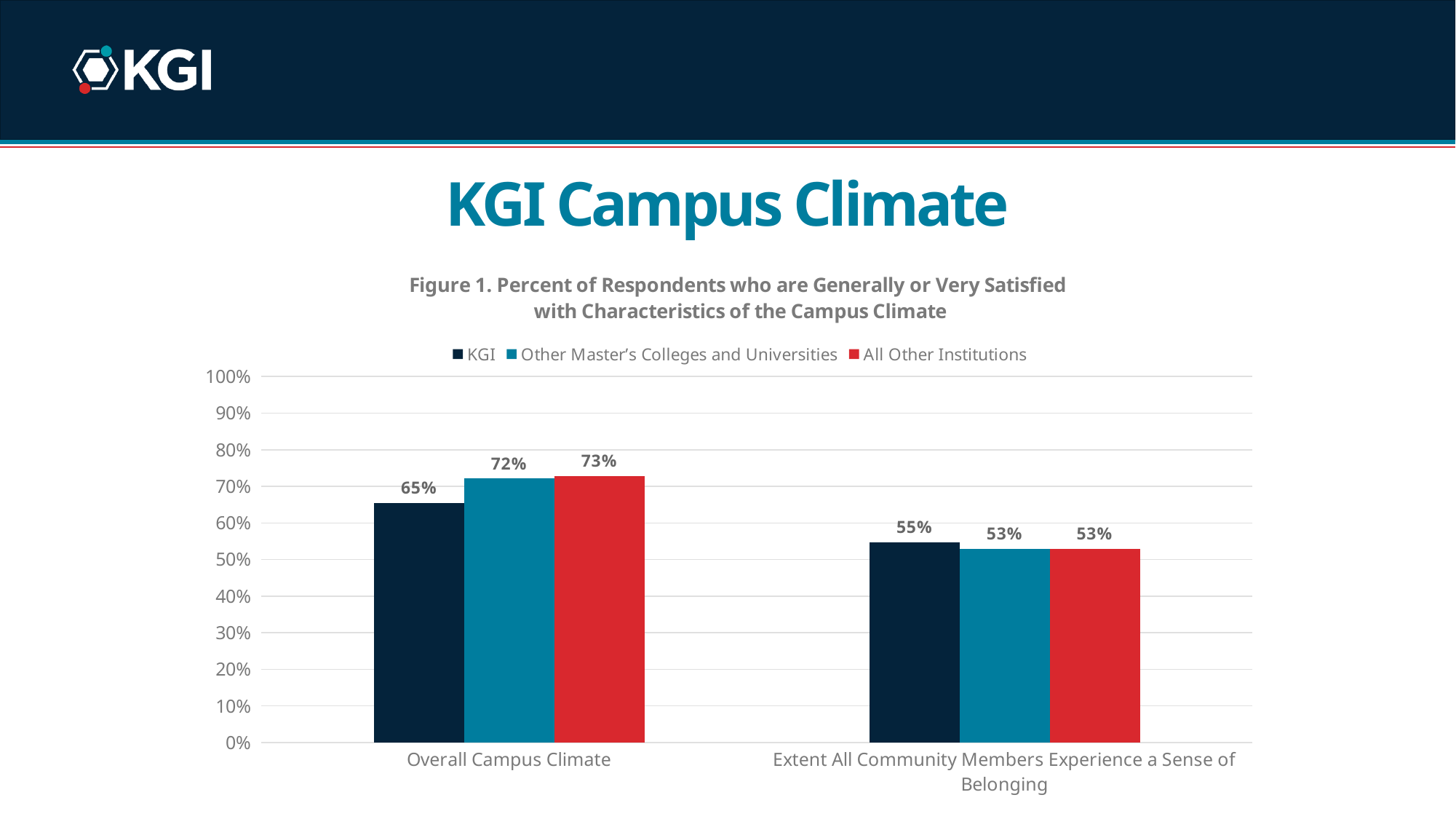
Which series has the highest value for Extent All Community Members Experience a Sense of Belonging? KGI What is the KGI value for Overall Campus Climate? 65% What is the value for All Other Institutions for Extent All Community Members Experience a Sense of Belonging? 53% How many categories are shown on the x axis? 2 What kind of chart is shown on the slide? bar chart What colour represents the All Other Institutions series? red How many series does the legend list? 3 What is the difference between the KGI values for Overall Campus Climate and Extent All Community Members Experience a Sense of Belonging? 10% Is the KGI value for Overall Campus Climate larger or smaller than the KGI value for Extent All Community Members Experience a Sense of Belonging? larger Which series has the highest value for Overall Campus Climate? All Other Institutions What is the difference between the All Other Institutions value and the KGI value for Overall Campus Climate? 8% What is the value for Other Master's Colleges and Universities for Overall Campus Climate? 72%